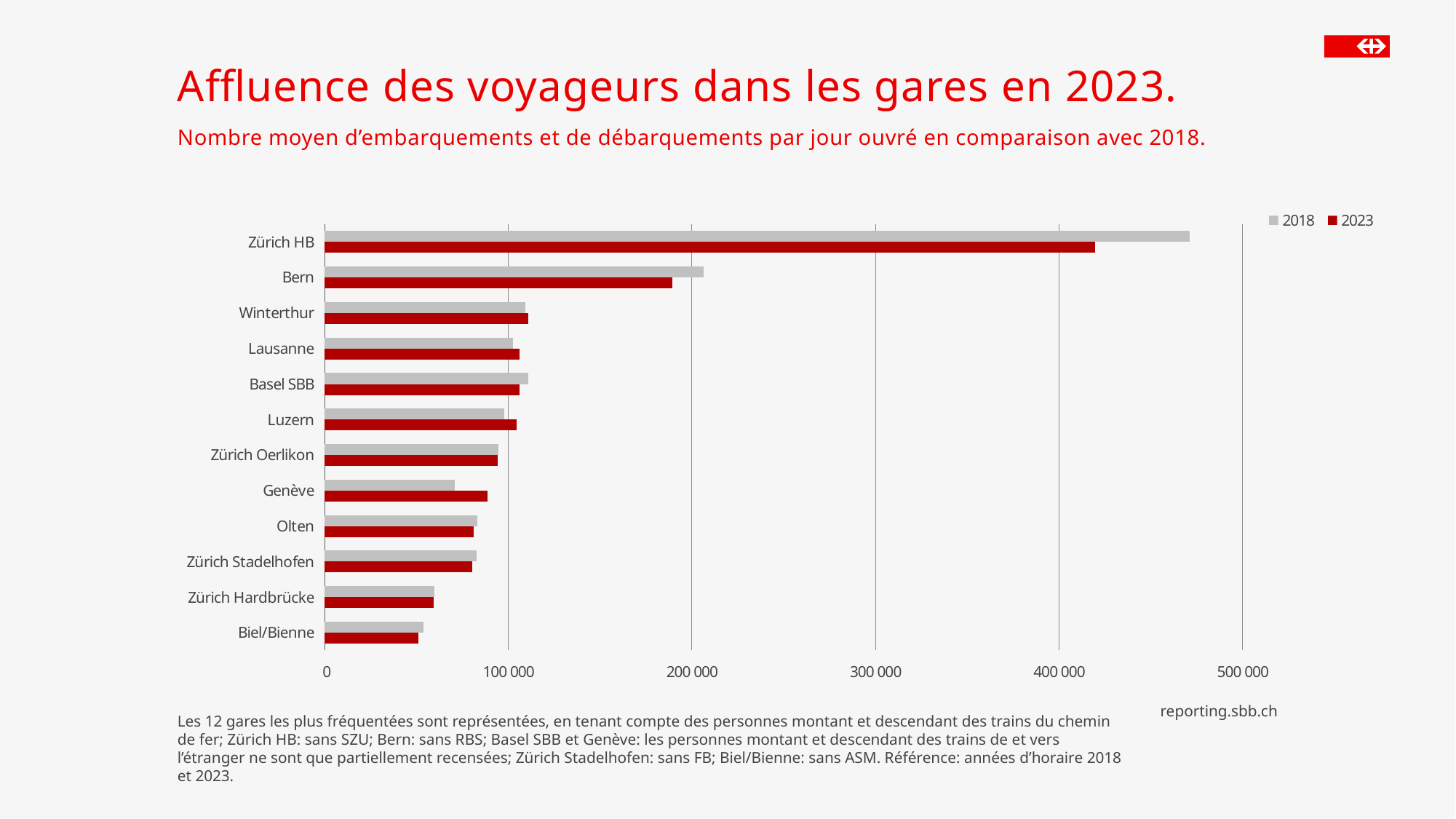
Which station has the highest value for 2023? Zürich HB Is the 2023 value for Bern greater or less than 200 000? less Which station has the lowest value for 2023? Biel/Bienne Is the 2018 value for Genève greater or less than 100 000? less Is the 2018 value for Zürich HB greater or less than 500 000? less What kind of chart is shown on the slide? bar chart How many stations are shown on the chart? 12 How many series does the legend list? 2 What colour are the bars for 2023? red For Genève, which year has the larger value, 2018 or 2023? 2023 For Zürich HB, which year has the larger value, 2018 or 2023? 2018